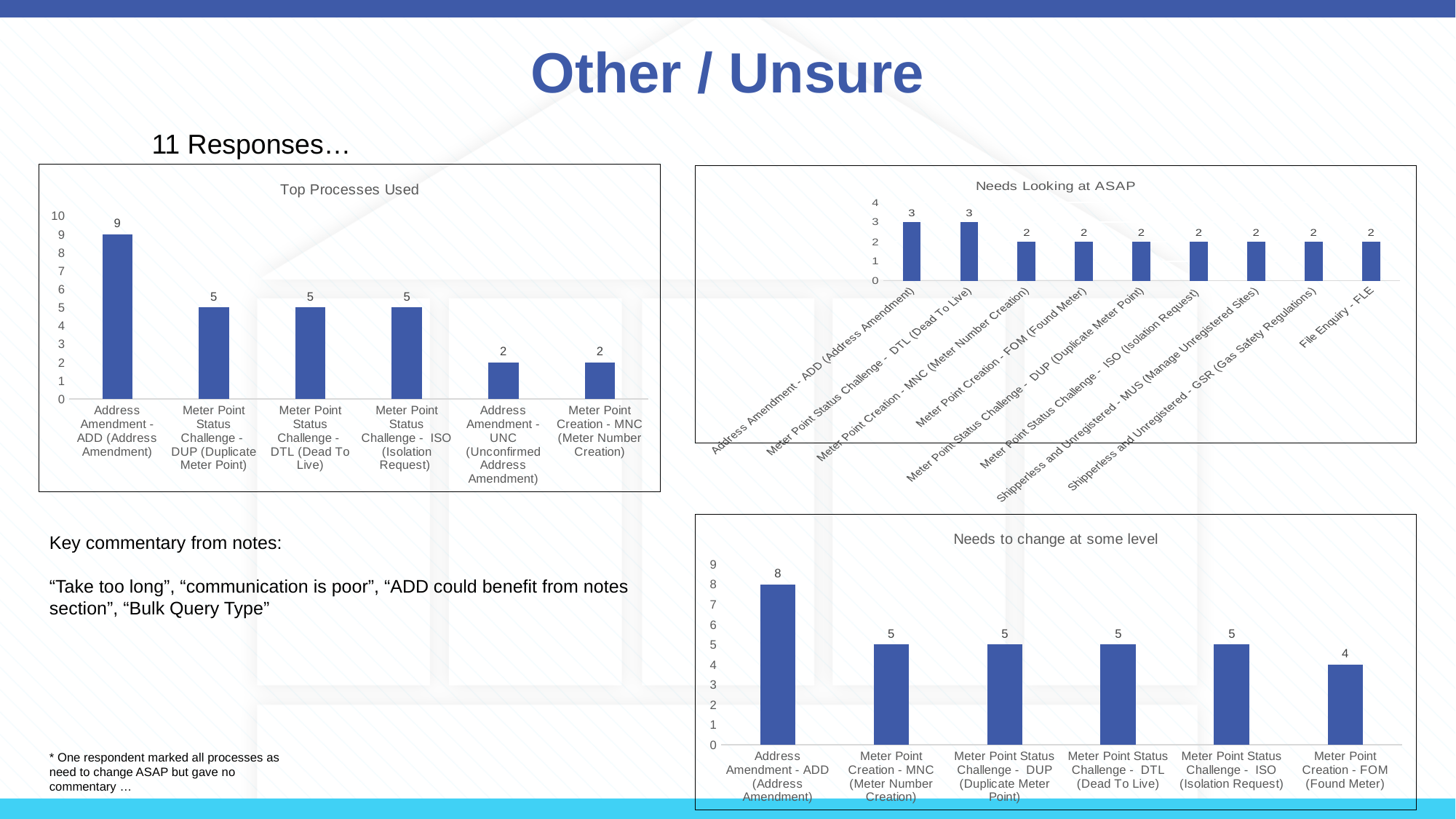
In the 'Needs to change at some level' chart, which is larger: the value for Address Amendment - ADD or the value for Meter Point Creation - MNC? Address Amendment - ADD In the 'Needs to change at some level' chart, what is the difference between the values for Address Amendment - ADD and Meter Point Creation - FOM? 4 How many categories are shown in the 'Top Processes Used' chart? 6 In the 'Top Processes Used' chart, what is the value for Address Amendment - ADD (Address Amendment)? 9 In the 'Top Processes Used' chart, which category has the highest value? Address Amendment - ADD (Address Amendment) How many categories are shown in the 'Needs Looking at ASAP' chart? 9 In the 'Needs Looking at ASAP' chart, what is the value for File Enquiry - FLE? 2 In the 'Top Processes Used' chart, what is the difference between the values for Address Amendment - ADD and Meter Point Creation - MNC? 7 In the 'Needs to change at some level' chart, what is the value for Meter Point Creation - FOM (Found Meter)? 4 In the 'Needs to change at some level' chart, which category has the lowest value? Meter Point Creation - FOM (Found Meter) In the 'Needs Looking at ASAP' chart, what is the value for Meter Point Status Challenge - DTL (Dead To Live)? 3 What type of chart is the 'Needs Looking at ASAP' chart? Bar chart